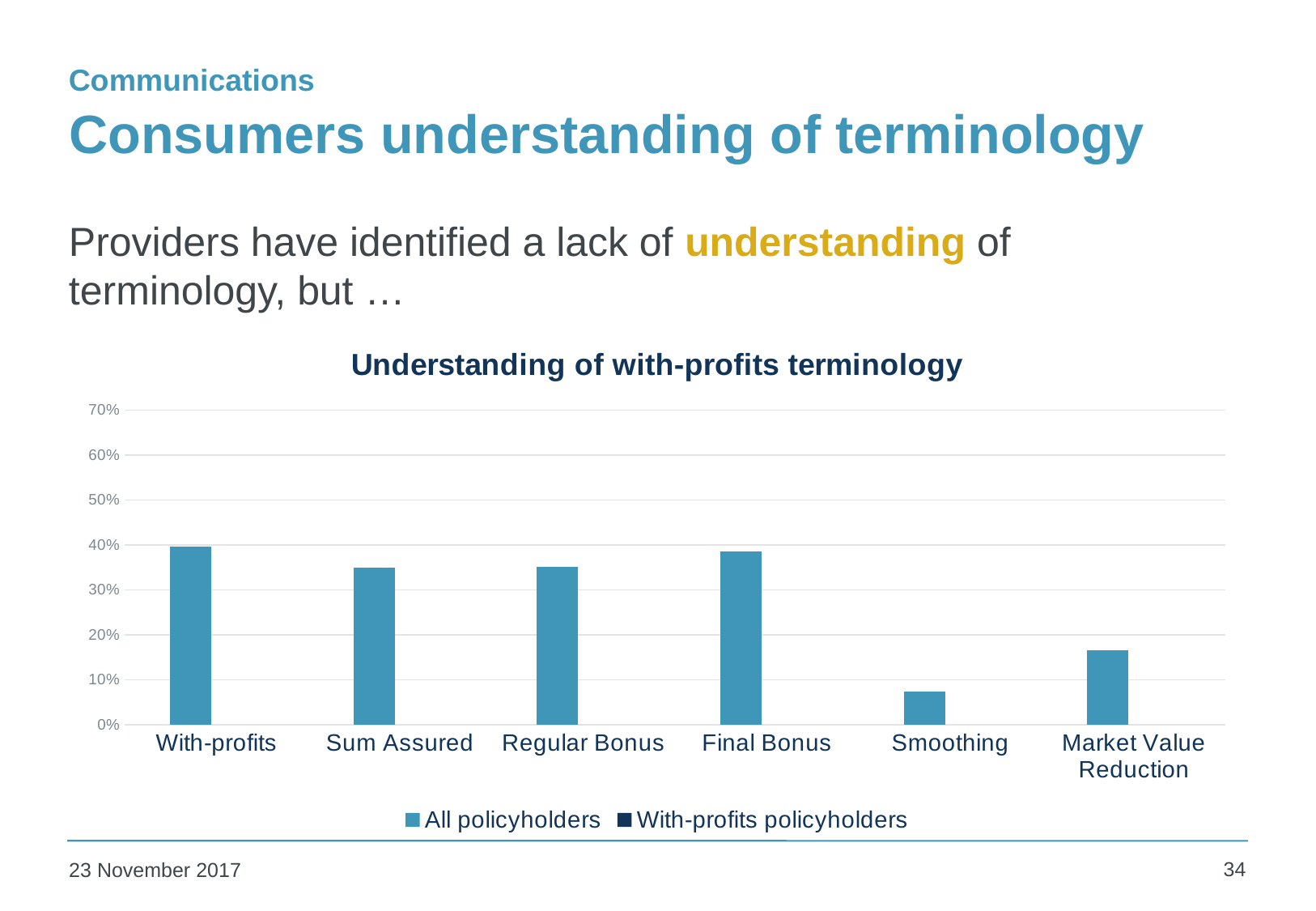
Which category has the lowest value in the chart? Smoothing What is the first series named in the chart legend? All policyholders Is the value for Final Bonus greater or less than 30%? greater How many categories are shown on the x axis of the chart? 6 Is the value for With-profits greater or less than 30%? greater What is the title of the chart? Understanding of with-profits terminology Is the value for Market Value Reduction greater or less than 20%? less Which is larger, the value for Final Bonus or the value for Market Value Reduction? Final Bonus How many series does the chart legend list? 2 What kind of chart is shown on the slide? bar chart Which is larger, the value for Smoothing or the value for Market Value Reduction? Market Value Reduction